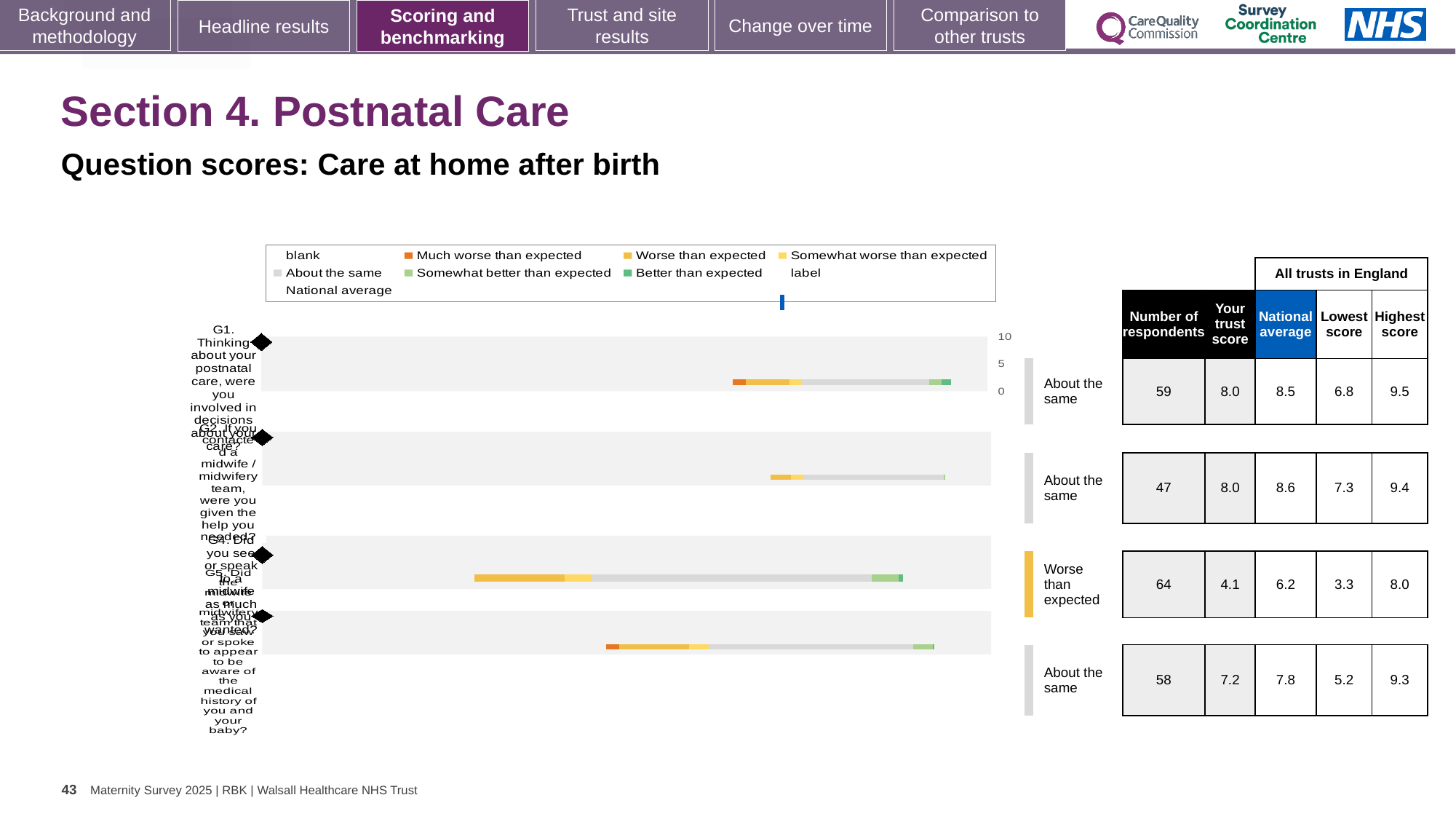
How many question bars (G1, G2, G4, G5) are plotted in the chart? 4 Which question is rated 'Worse than expected'? G4 How many entries does the chart legend list? 9 What is the number of respondents for question G1? 59 What is the difference between the national average (8.5) and the trust score (8.0) for question G1? 0.5 What colour does the legend use for 'Much worse than expected'? orange What kind of chart is used to show the question scores for care at home after birth? bar chart Which question has the lowest trust score? G4 What is the lowest score across all trusts in England for question G5? 5.2 What is the national average score for question G2? 8.6 Which is larger for question G4: the trust score or the national average? national average What is the 'Your trust score' for question G4 (Did you see or speak to a midwife as much as you wanted?)? 4.1